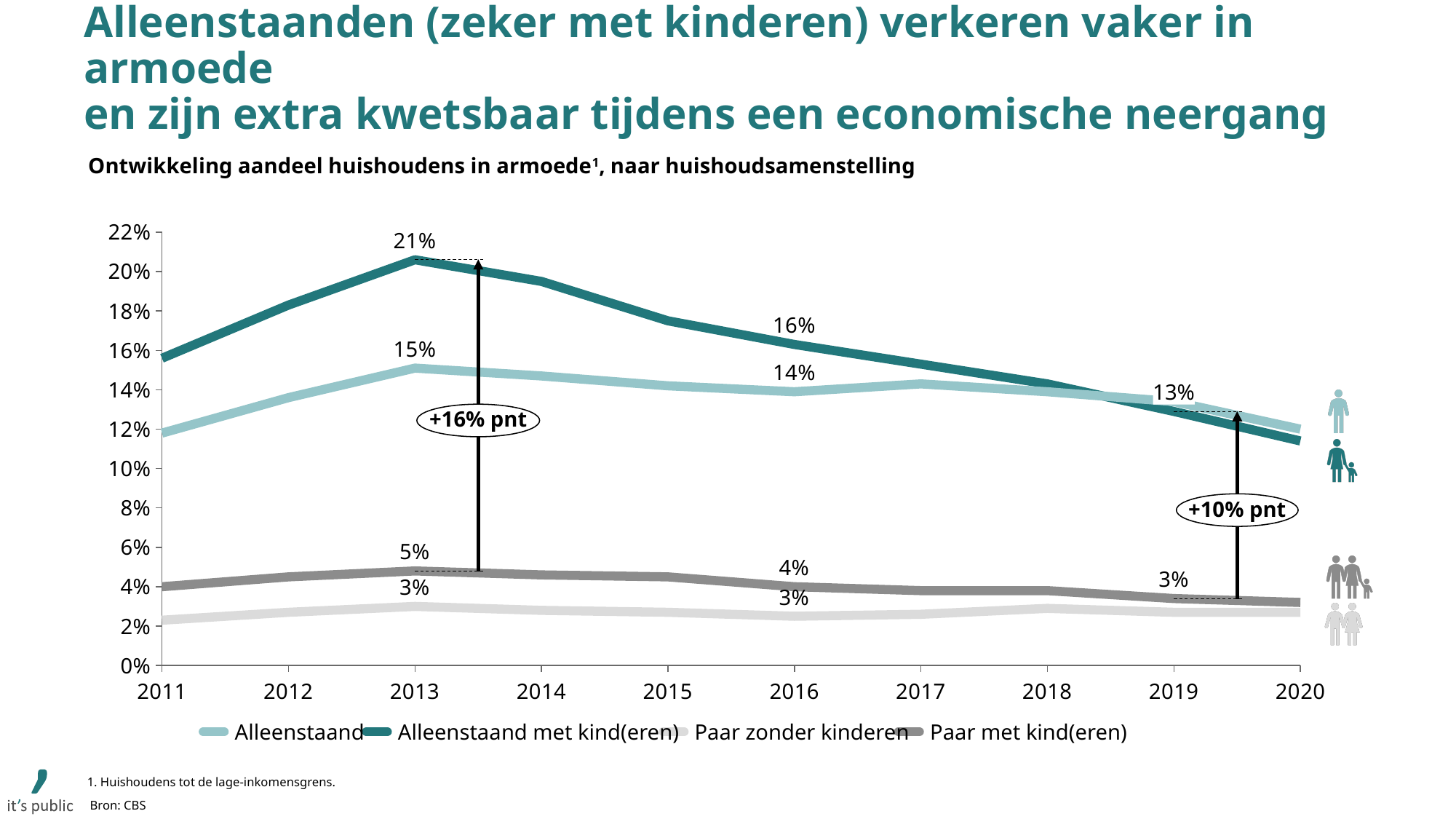
What is the value for 'Alleenstaand' in 2013? 15% Does the 'Alleenstaand met kind(eren)' line rise or fall between 2013 and 2020? fall What is the value for 'Alleenstaand met kind(eren)' in 2013? 21% Is the value for 'Alleenstaand met kind(eren)' in 2011 greater or less than 14%? greater How many years are shown on the x axis? 10 What is the value for 'Paar met kind(eren)' in 2019? 3% What is the difference between 'Alleenstaand met kind(eren)' and 'Paar met kind(eren)' in 2013? 16% pnt Which series has the lowest value in 2016? Paar zonder kinderen What kind of chart is shown on the slide? line chart How many series does the legend list? 4 What is the value for 'Alleenstaand met kind(eren)' in 2016? 16% Which series has the highest value in 2013? Alleenstaand met kind(eren)